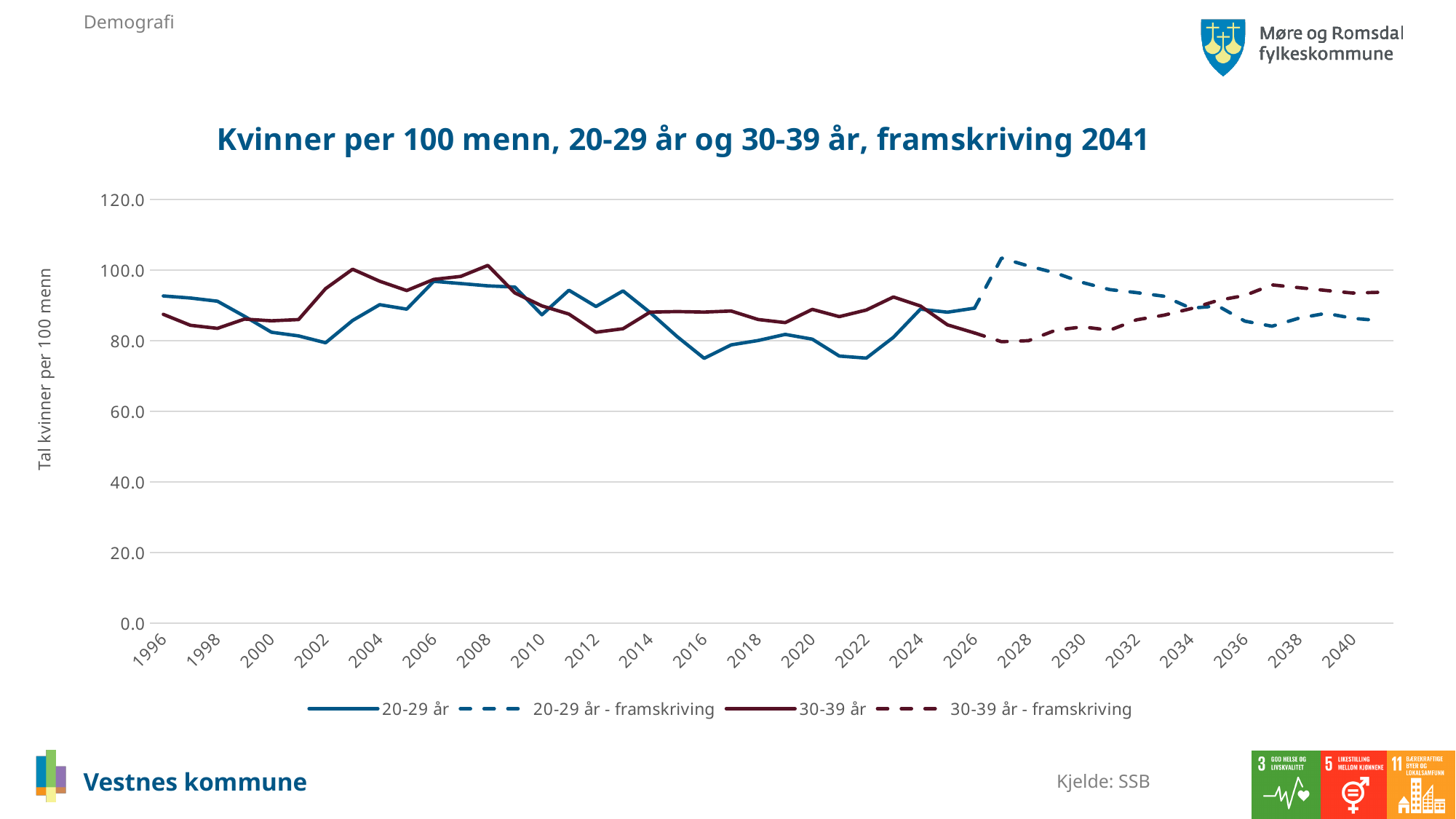
In 2013, which series has the higher value, 20-29 år or 30-39 år? 20-29 år Does the 20-29 år - framskriving series generally rise or fall from 2027 to 2040? fall Is the value for 20-29 år in 2016 greater or less than 80? less Is the value for 30-39 år in 2016 greater or less than 80? greater In 2016, which series has the higher value, 20-29 år or 30-39 år? 30-39 år What is the title of the chart? Kvinner per 100 menn, 20-29 år og 30-39 år, framskriving 2041 What is the label on the vertical axis? Tal kvinner per 100 menn How many series does the legend list? 4 Is the value for 20-29 år in 2022 greater or less than 80? less Does the 30-39 år - framskriving series generally rise or fall from 2028 to 2040? rise In 2003, which series has the higher value, 20-29 år or 30-39 år? 30-39 år What kind of chart is shown on the slide? line chart